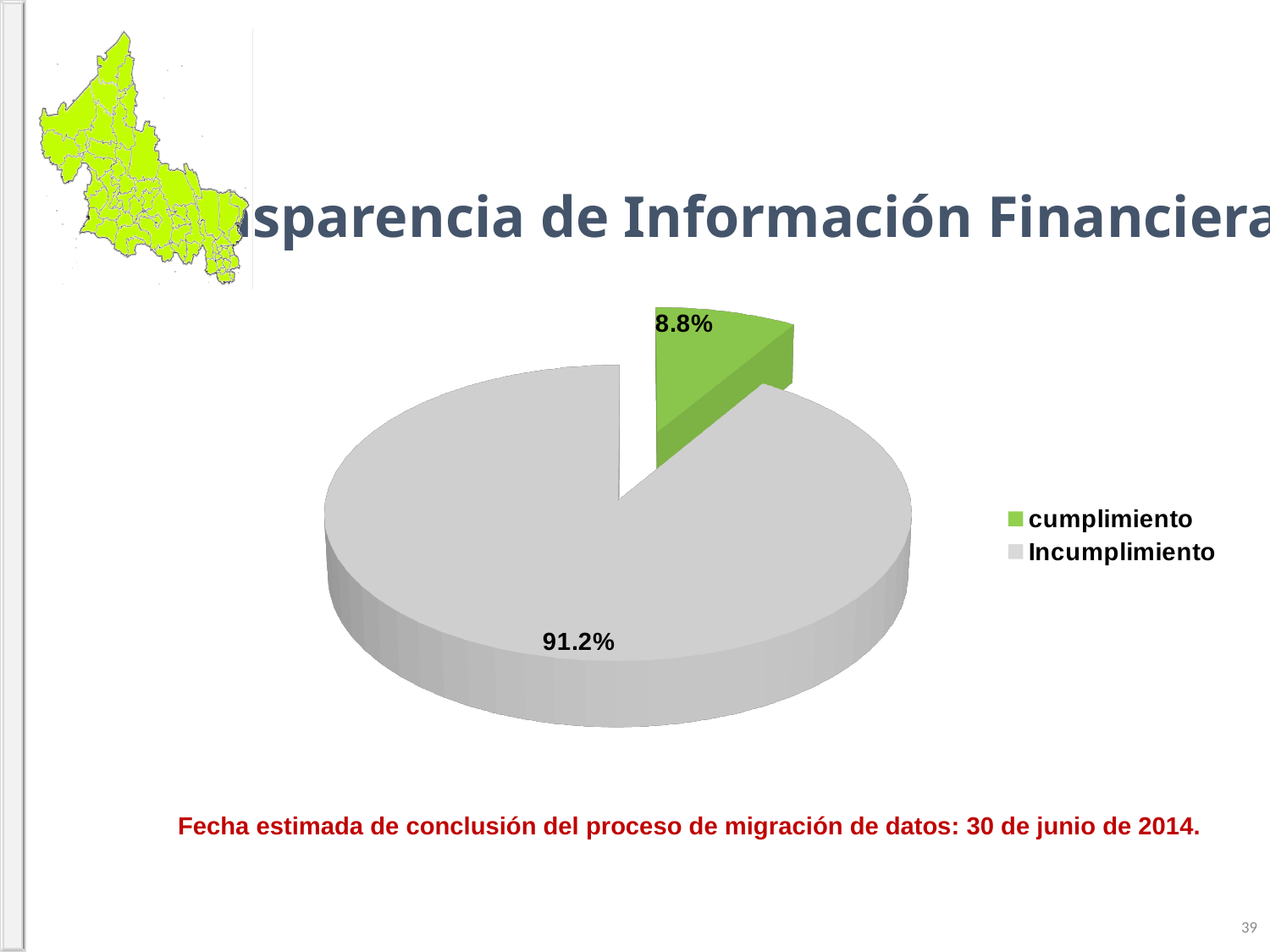
What colour is the Incumplimiento slice? grey What colour is the cumplimiento slice? green How many entries does the legend list? 2 Which slice of the pie is the smallest? cumplimiento Which is larger, cumplimiento or Incumplimiento? Incumplimiento What kind of chart is shown on the slide? pie chart What is the difference in percentage points between Incumplimiento and cumplimiento? 82.4 What share of the pie does cumplimiento represent? 8.8% How many slices does the pie chart have? 2 Which slice of the pie is the largest? Incumplimiento What share of the pie does Incumplimiento represent? 91.2%